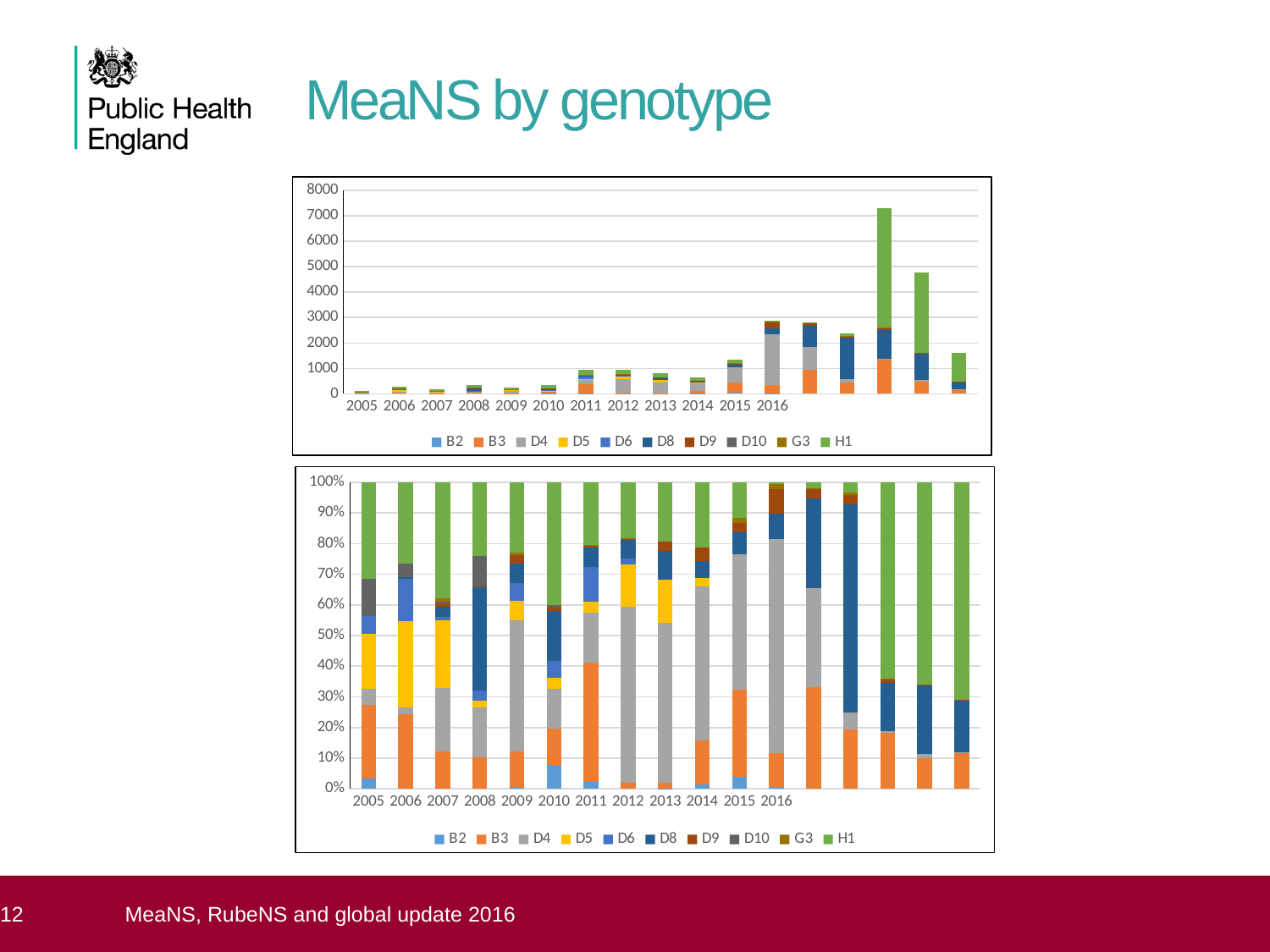
How many series does the legend of the top chart list? 10 In the bottom chart, is the H1 share for 2016 greater or less than 10%? less What kind of chart is the top chart on the slide? Stacked bar chart In the bottom chart, is the H1 share for 2010 greater or less than 30%? greater In the top chart, among the years labelled 2005 to 2016, which year has the tallest bar? 2016 In the top chart, do the bar totals generally rise or fall from 2005 to 2016? rise In the top chart, which bar is taller, 2016 or 2015? 2016 In the top chart, is the total bar height for 2016 greater or less than 2000? greater What colour represents the H1 series in the legends? Green